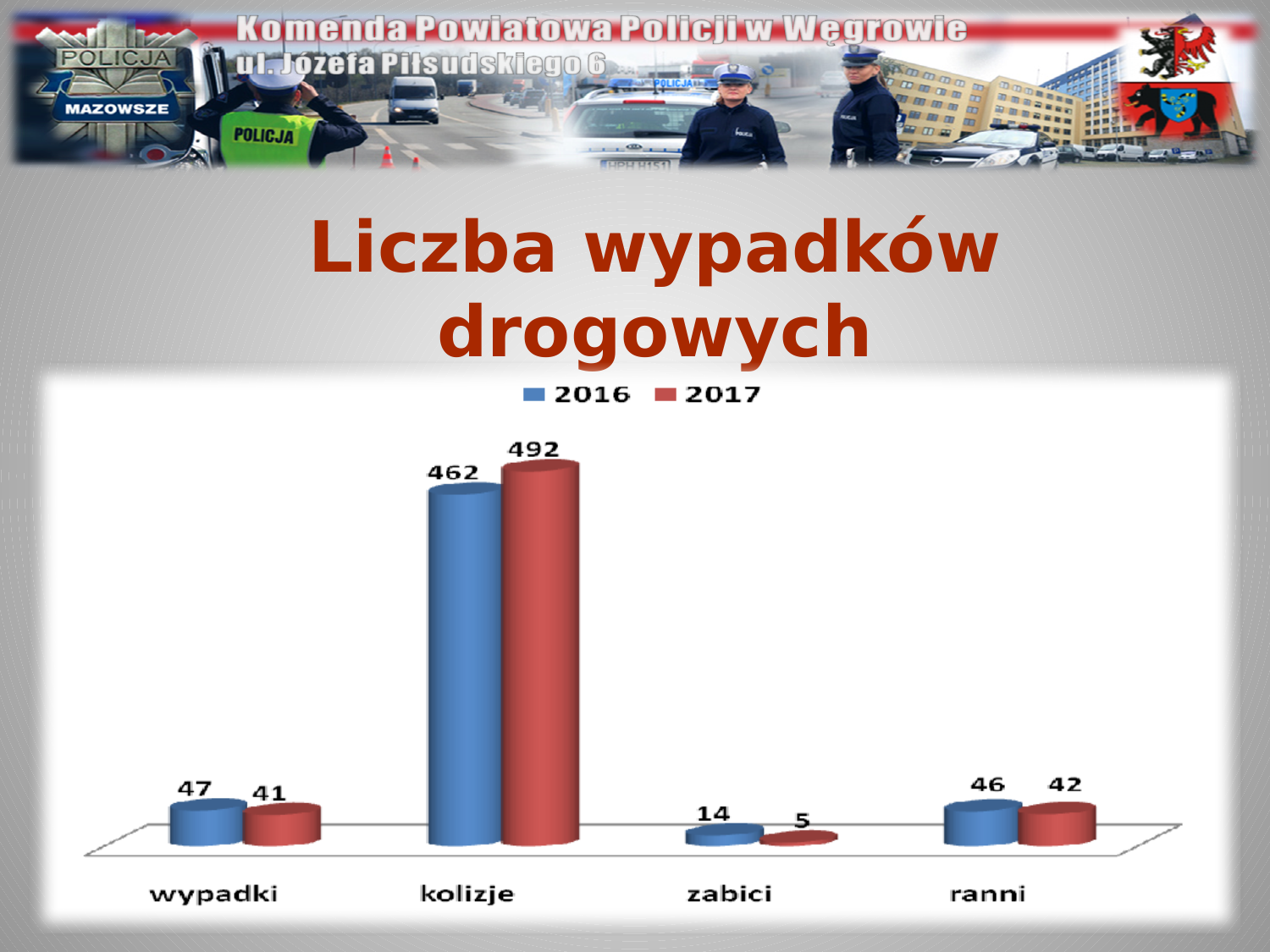
What is the value for ranni in 2016? 46 Which category has the highest value in 2016? kolizje How many categories are shown on the x axis? 4 What is the value for kolizje in 2017? 492 What is the difference between the 2016 and 2017 values for zabici? 9 What is the value for wypadki in 2016? 47 Which category has the lowest value in 2017? zabici Which is larger for wypadki, the 2016 value or the 2017 value? 2016 How many series does the legend list? 2 What is the value for zabici in 2017? 5 What is the difference between the 2017 and 2016 values for kolizje? 30 What kind of chart is shown on the slide? bar chart